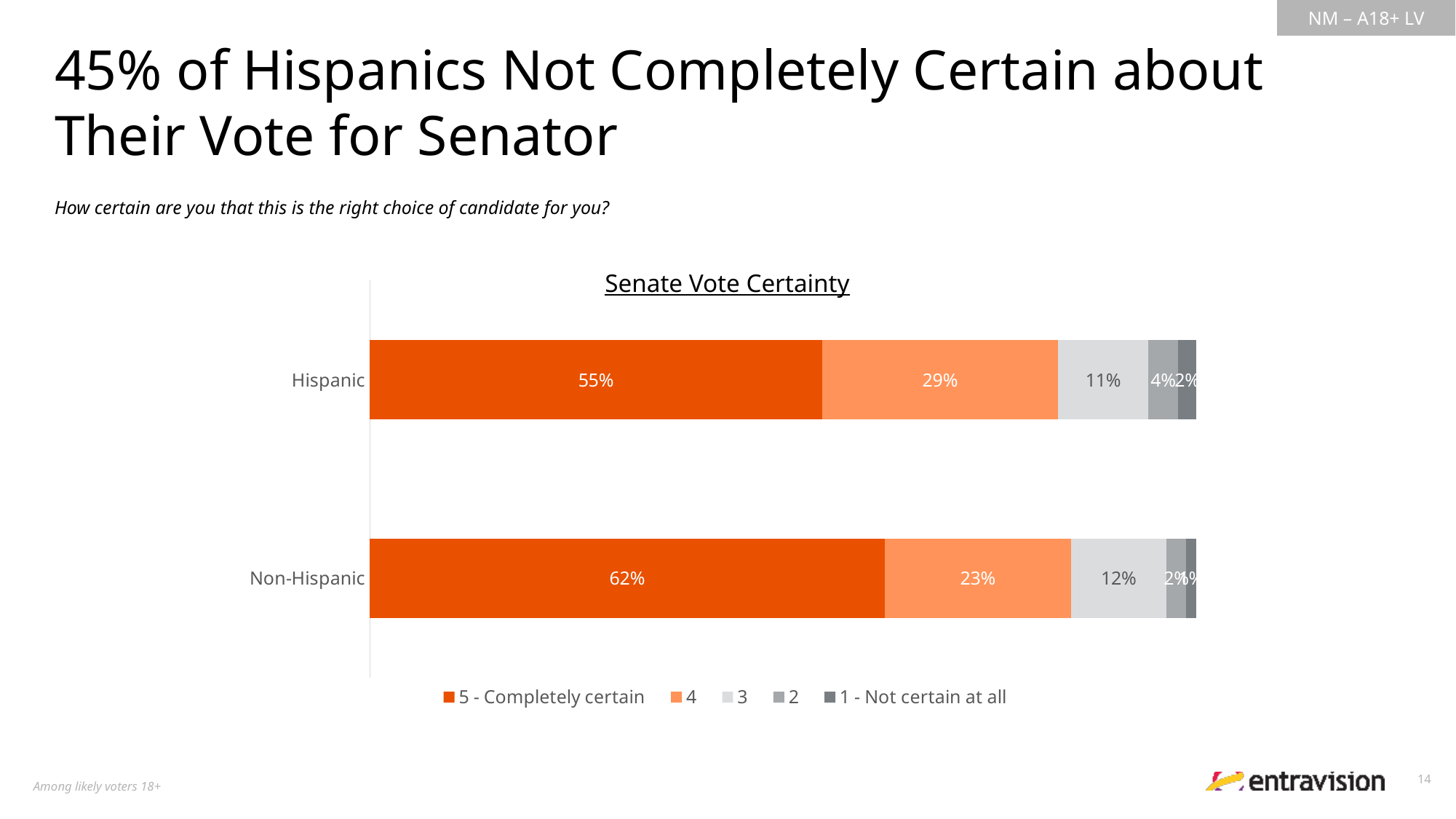
What percentage of Hispanic voters are '5 - Completely certain' about their Senate vote? 55% What is the difference in percentage points between Hispanic and Non-Hispanic voters who gave a '4' rating? 6 percentage points How many groups (categories) are plotted in the Senate Vote Certainty chart? 2 What is the value for the '4' rating among Hispanic voters? 29% Which group has a larger share of '5 - Completely certain' voters, Hispanic or Non-Hispanic? Non-Hispanic What percentage of Non-Hispanic voters are '5 - Completely certain' about their Senate vote? 62% What is the value for the '3' rating among Non-Hispanic voters? 12% How many series does the legend of the Senate Vote Certainty chart list? 5 What is the value for the '3' rating among Hispanic voters? 11% What is the difference in percentage points between Non-Hispanic and Hispanic voters who are '5 - Completely certain'? 7 percentage points What kind of chart is shown on the slide? Stacked bar chart What is the title of the chart on the slide? Senate Vote Certainty